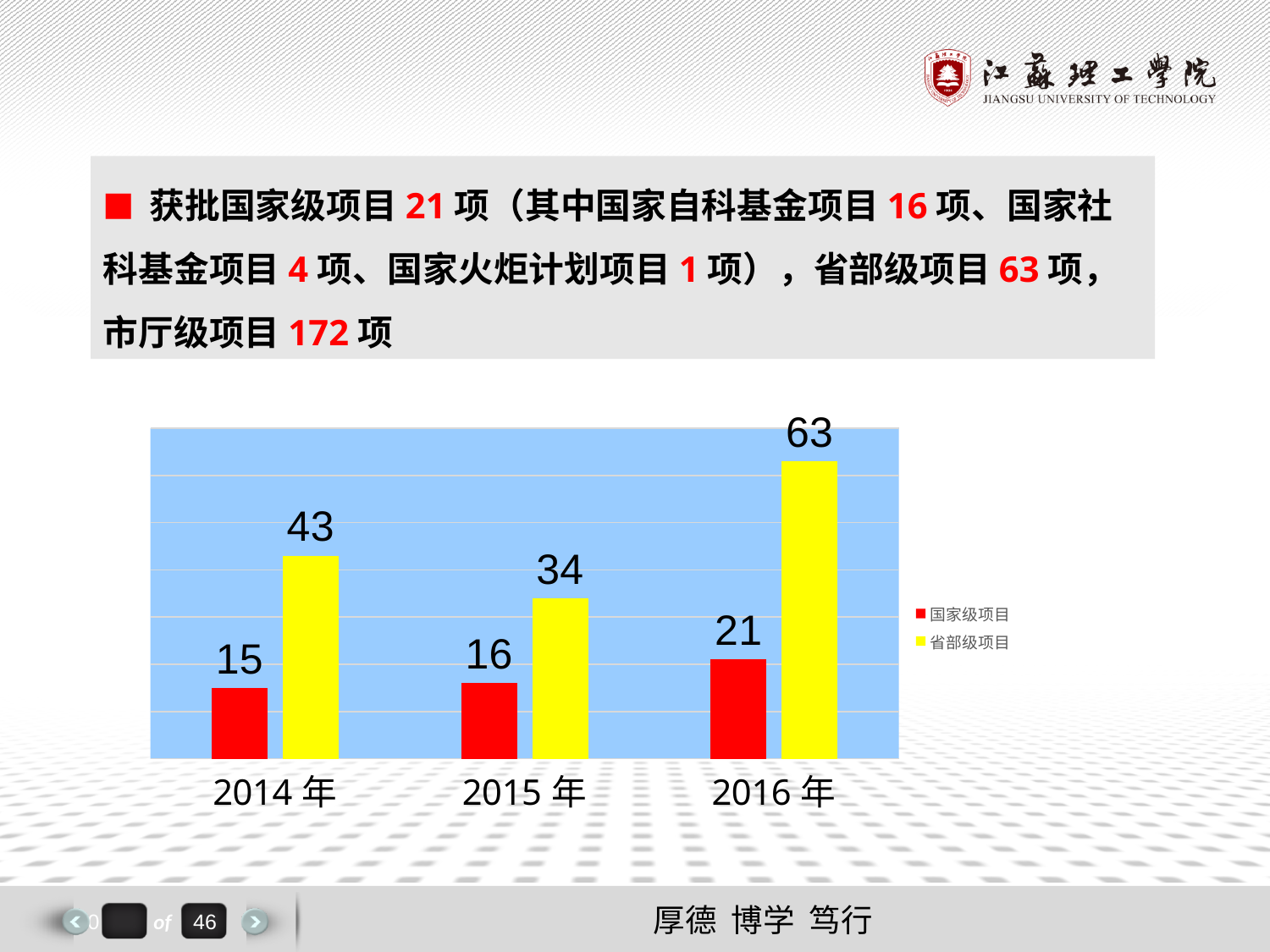
How many series does the legend list? 2 Does the value for 国家级项目 rise or fall from 2014 年 to 2016 年? rise Which year has the lowest value for 国家级项目? 2014 年 Which is larger: 省部级项目 in 2014 年 or 省部级项目 in 2015 年? 2014 年 What is the value for 省部级项目 in 2015 年? 34 How many years are shown on the x axis? 3 What is the value for 国家级项目 in 2014 年? 15 What is the value for 省部级项目 in 2016 年? 63 What is the difference between 省部级项目 and 国家级项目 in 2016 年? 42 What is the difference between 省部级项目 in 2014 年 and 2015 年? 9 What kind of chart is shown on the slide? bar chart Which year has the highest value for 省部级项目? 2016 年